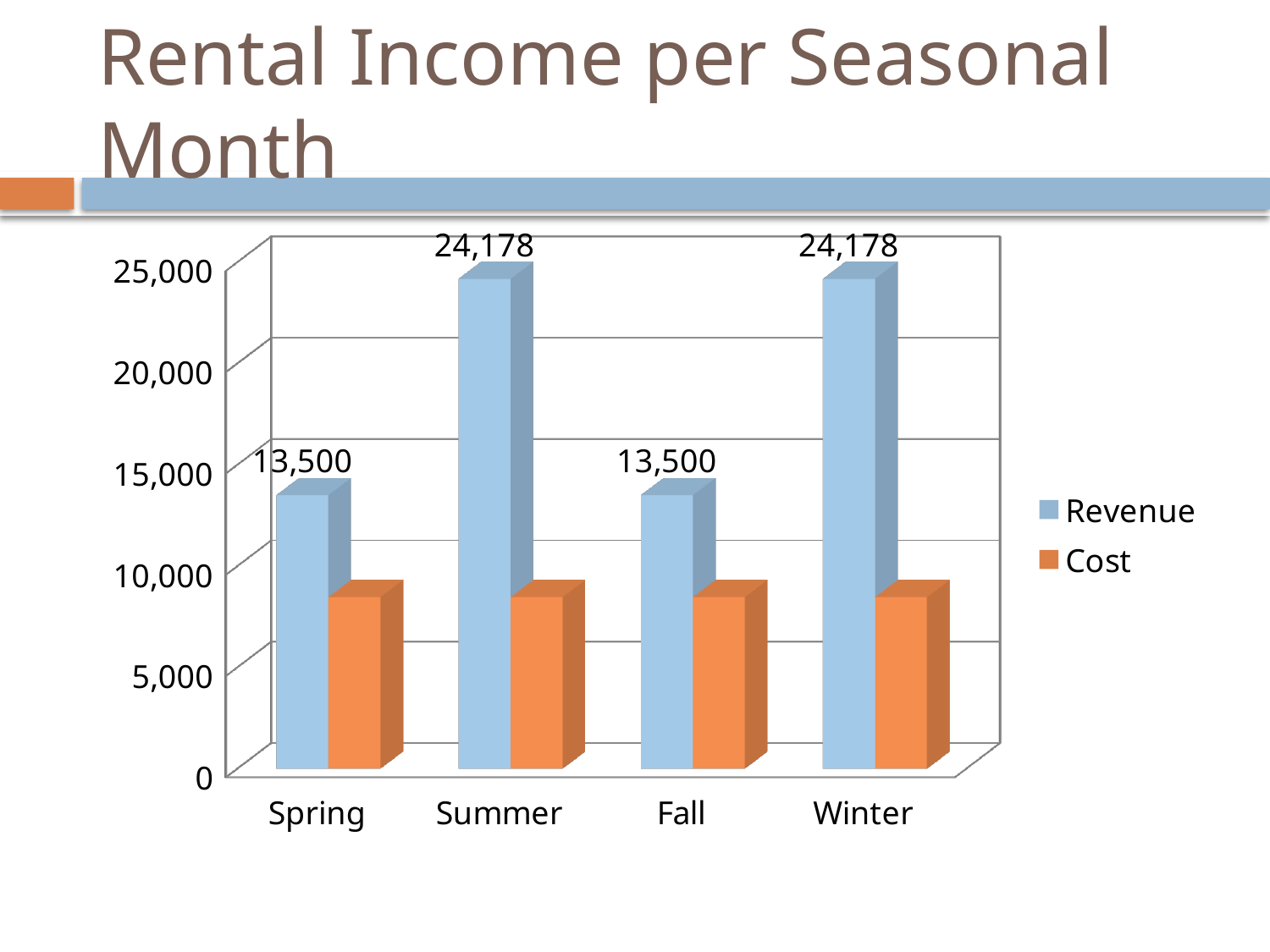
What is the Revenue value for Fall? 13,500 What is the Revenue value for Summer? 24,178 What is the Revenue value for Winter? 24,178 How many series does the legend list? 2 Which is larger, the Revenue for Summer or the Revenue for Spring? Summer Is the Cost value for Summer greater or less than 5,000? greater Is the Cost value for Spring greater or less than 10,000? less What is the difference between the Revenue for Winter and the Revenue for Fall? 10,678 Which colour represents Cost in the legend? Orange What is the Revenue value for Spring? 13,500 What kind of chart is shown on the slide? Bar chart How many seasons are shown on the x axis? 4